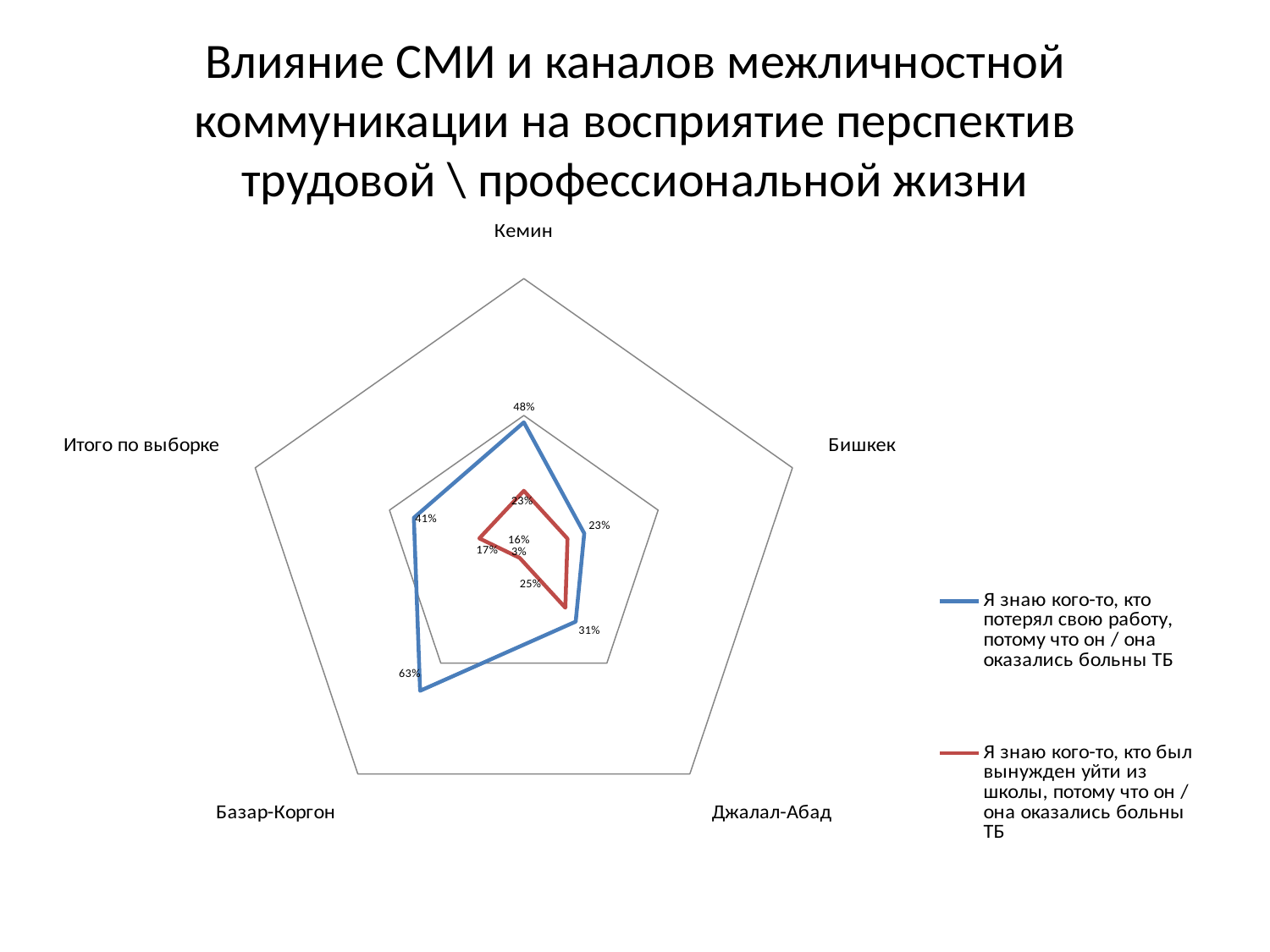
Which category has the lowest value in the series 'Я знаю кого-то, кто был вынужден уйти из школы, потому что он / она оказались больны ТБ'? Базар-Коргон What is the value for Итого по выборке in the series 'Я знаю кого-то, кто потерял свою работу, потому что он / она оказались больны ТБ'? 41% What is the value for Джалал-Абад in the series 'Я знаю кого-то, кто был вынужден уйти из школы, потому что он / она оказались больны ТБ'? 25% What type of chart is shown on the slide? Radar chart What is the value for Кемин in the series 'Я знаю кого-то, кто был вынужден уйти из школы, потому что он / она оказались больны ТБ'? 23% What is the difference between the two series' values for Кемин? 25% What colour is the line for the series 'Я знаю кого-то, кто был вынужден уйти из школы, потому что он / она оказались больны ТБ'? Red How many categories (axes) does the radar chart have? 5 What is the value for Базар-Коргон in the series 'Я знаю кого-то, кто потерял свою работу, потому что он / она оказались больны ТБ'? 63% Which category has the highest value in the series 'Я знаю кого-то, кто потерял свою работу, потому что он / она оказались больны ТБ'? Базар-Коргон For Бишкек, which series has the larger value: 'Я знаю кого-то, кто потерял свою работу...' or 'Я знаю кого-то, кто был вынужден уйти из школы...'? Я знаю кого-то, кто потерял свою работу, потому что он / она оказались больны ТБ How many series does the legend list? 2